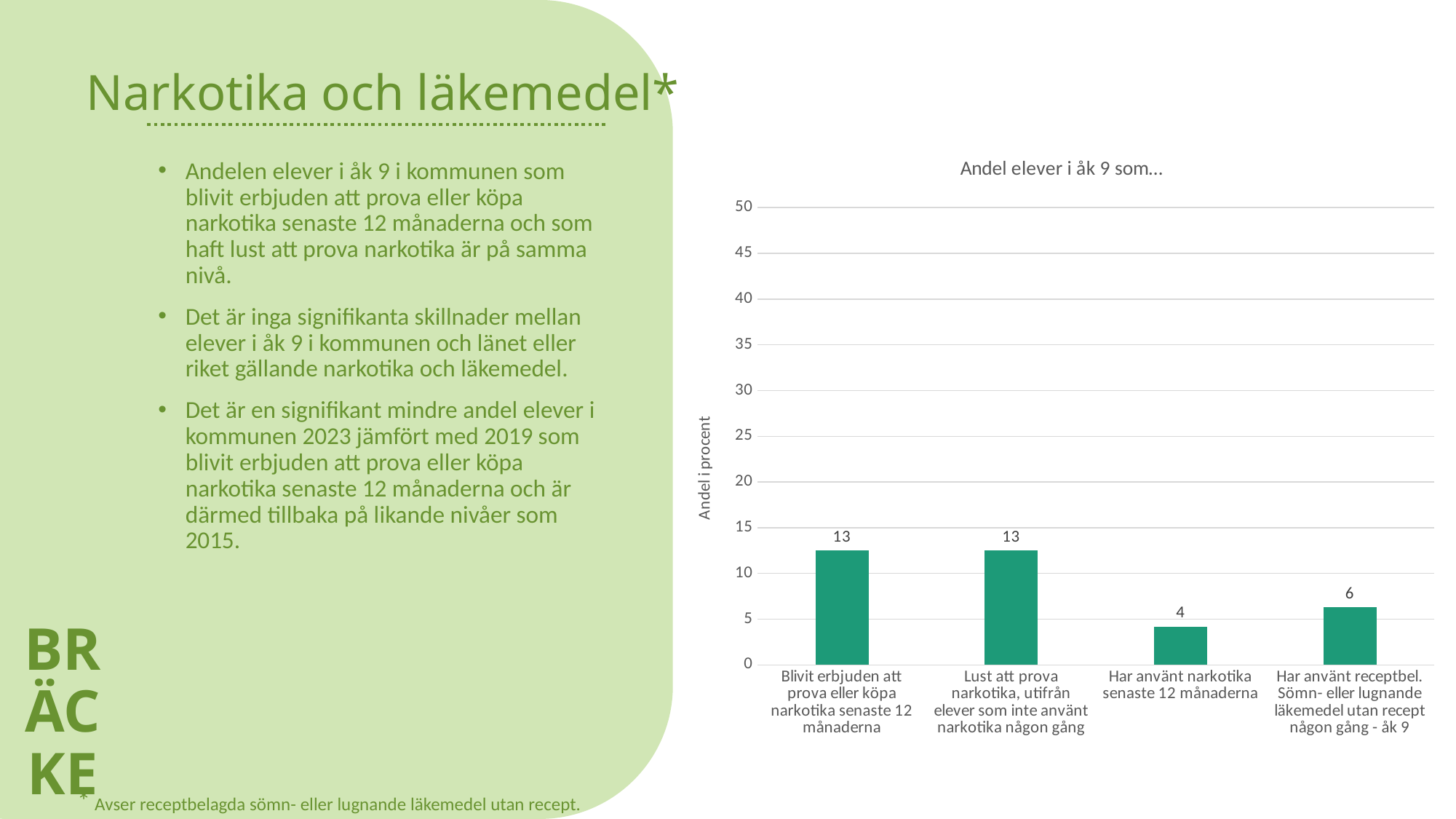
What is the label of the y axis of the chart? Andel i procent How many categories are shown on the x axis of the chart? 4 Which category has the lowest value? Har använt narkotika senaste 12 månaderna What is the value for 'Har använt narkotika senaste 12 månaderna'? 4 What is the difference between the value for 'Har använt receptbel. Sömn- eller lugnande läkemedel utan recept någon gång - åk 9' and the value for 'Har använt narkotika senaste 12 månaderna'? 2 What type of chart is shown on the slide? bar chart What is the title of the chart? Andel elever i åk 9 som... Which is larger: the value for 'Lust att prova narkotika, utifrån elever som inte använt narkotika någon gång' or the value for 'Har använt receptbel. Sömn- eller lugnande läkemedel utan recept någon gång - åk 9'? Lust att prova narkotika, utifrån elever som inte använt narkotika någon gång What is the value for 'Har använt receptbel. Sömn- eller lugnande läkemedel utan recept någon gång - åk 9'? 6 What is the value for 'Blivit erbjuden att prova eller köpa narkotika senaste 12 månaderna'? 13 What is the difference between the value for 'Blivit erbjuden att prova eller köpa narkotika senaste 12 månaderna' and the value for 'Har använt narkotika senaste 12 månaderna'? 9 What is the value for 'Lust att prova narkotika, utifrån elever som inte använt narkotika någon gång'? 13